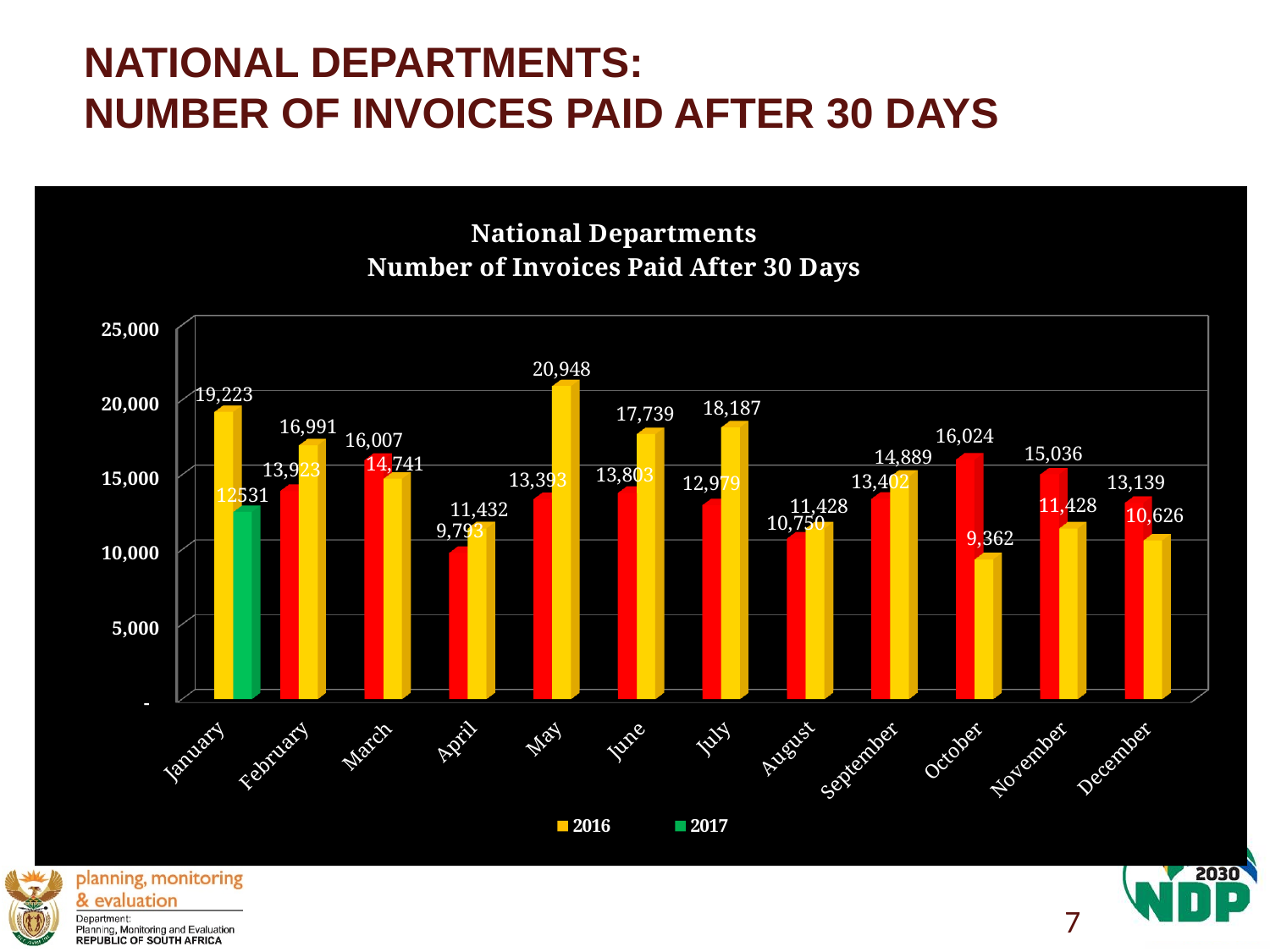
What is the difference between the 2016 and 2017 values for January? 6,692 What is the 2017 value for January? 12531 What kind of chart is shown? bar chart What is the 2016 value for May? 20,948 Which is larger, the 2016 value for June or the 2016 value for July? July Is the 2016 value for April greater or less than 10,000? greater Which month has the highest 2016 value? May Which month has the lowest 2016 value? October How many series does the legend list? 2 What is the 2016 value for December? 10,626 How many months are shown on the x axis? 12 What is the difference between the 2016 values for May and October? 11,586